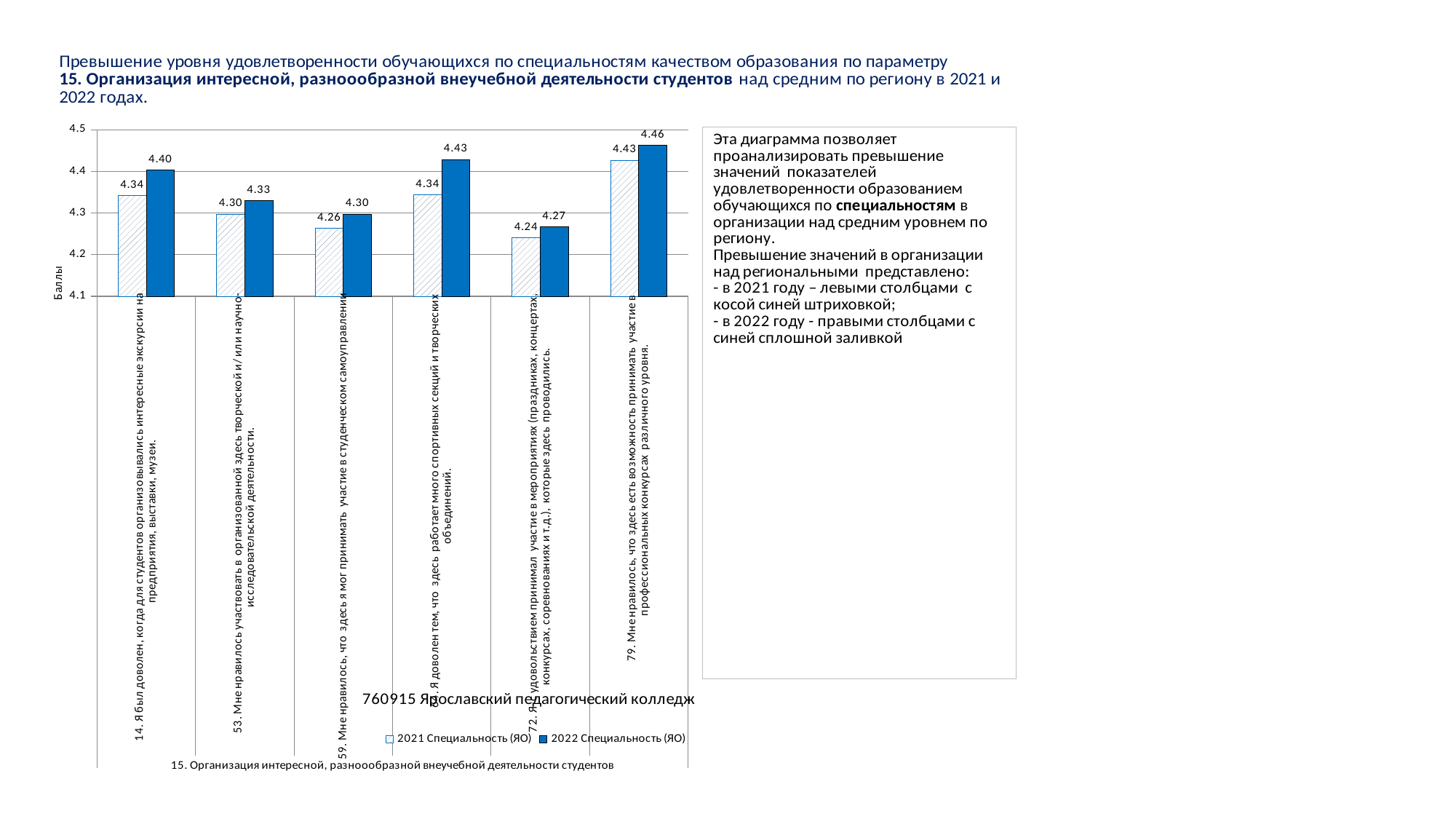
What is the label of the vertical axis? Баллы Which is larger for statement 53: the 2021 Специальность (ЯО) value or the 2022 Специальность (ЯО) value? 2022 Специальность (ЯО) What type of chart is shown on the slide? bar chart Which statement has the lowest 2021 Специальность (ЯО) value? 72. Я с удовольствием принимал участие в мероприятиях (праздниках, концертах, конкурсах, соревнованиях и т.д.), которые здесь проводились. How many series does the legend list? 2 Is the 2021 Специальность (ЯО) value for statement 79 greater or less than 4.4? greater How many categories (statements) are plotted on the chart? 6 What is the difference between the 2022 and 2021 values for the statement about sports sections and creative associations (Я доволен тем, что здесь работает много спортивных секций и творческих объединений)? 0.09 Which statement has the highest 2022 Специальность (ЯО) value? 79. Мне нравилось, что здесь есть возможность принимать участие в профессиональных конкурсах различного уровня. What is the 2022 Специальность (ЯО) value for statement 14 (Я был доволен, когда для студентов организовывались интересные экскурсии на предприятия, выставки, музеи)? 4.40 What is the 2021 Специальность (ЯО) value for statement 72 (Я с удовольствием принимал участие в мероприятиях)? 4.24 What is the 2021 Специальность (ЯО) value for statement 59 (Мне нравилось, что здесь я мог принимать участие в студенческом самоуправлении)? 4.26